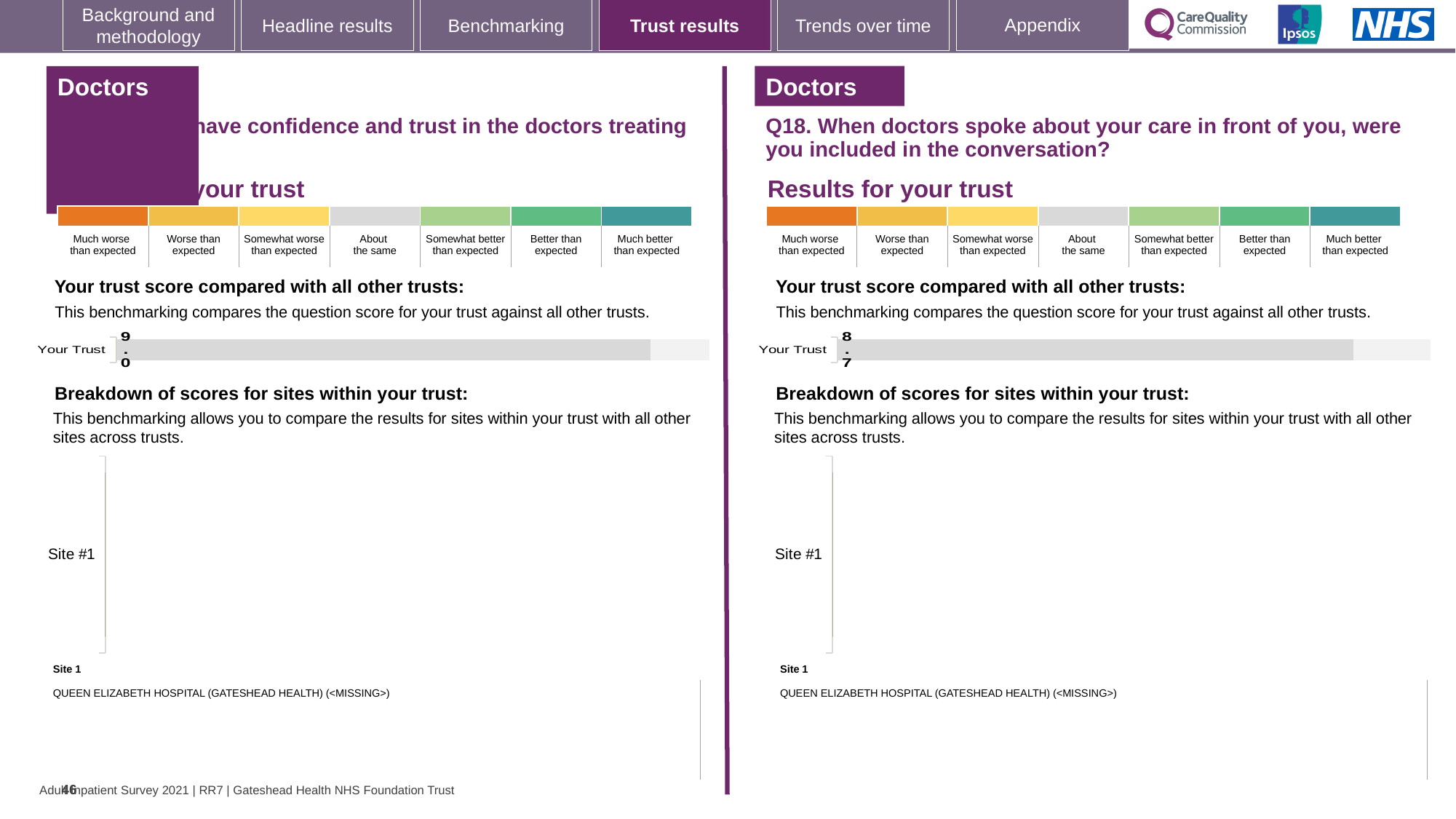
Which hospital is named as Site 1 in the site breakdown on the right-hand Q18 panel? QUEEN ELIZABETH HOSPITAL (GATESHEAD HEALTH) How many sites are listed in the 'Breakdown of scores for sites within your trust' chart on the right-hand Q18 panel? 1 Which Your Trust score is larger: the left-hand chart (confidence and trust in doctors) or the right-hand chart (Q18)? The left-hand chart (9.0) How many bars are plotted in the 'Your trust score compared with all other trusts' chart on the left-hand panel? 1 On the left-hand chart about confidence and trust in the doctors treating you, what is the score shown for Your Trust? 9.0 What kind of chart is used to show the Your Trust score on the Q18 panel? Bar chart What is the difference between the Your Trust score on the left-hand chart (9.0) and the Your Trust score on the right-hand Q18 chart (8.7)? 0.3 How many rating categories does the colour scale above the Q18 chart show, from 'Much worse than expected' to 'Much better than expected'? 7 On the colour scale above the Q18 chart, what colour represents 'Much worse than expected'? Orange On the right-hand chart for Q18 (When doctors spoke about your care in front of you, were you included in the conversation?), what is the score shown for Your Trust? 8.7 On the right-hand Q18 chart, is the Your Trust score greater or less than 8? greater